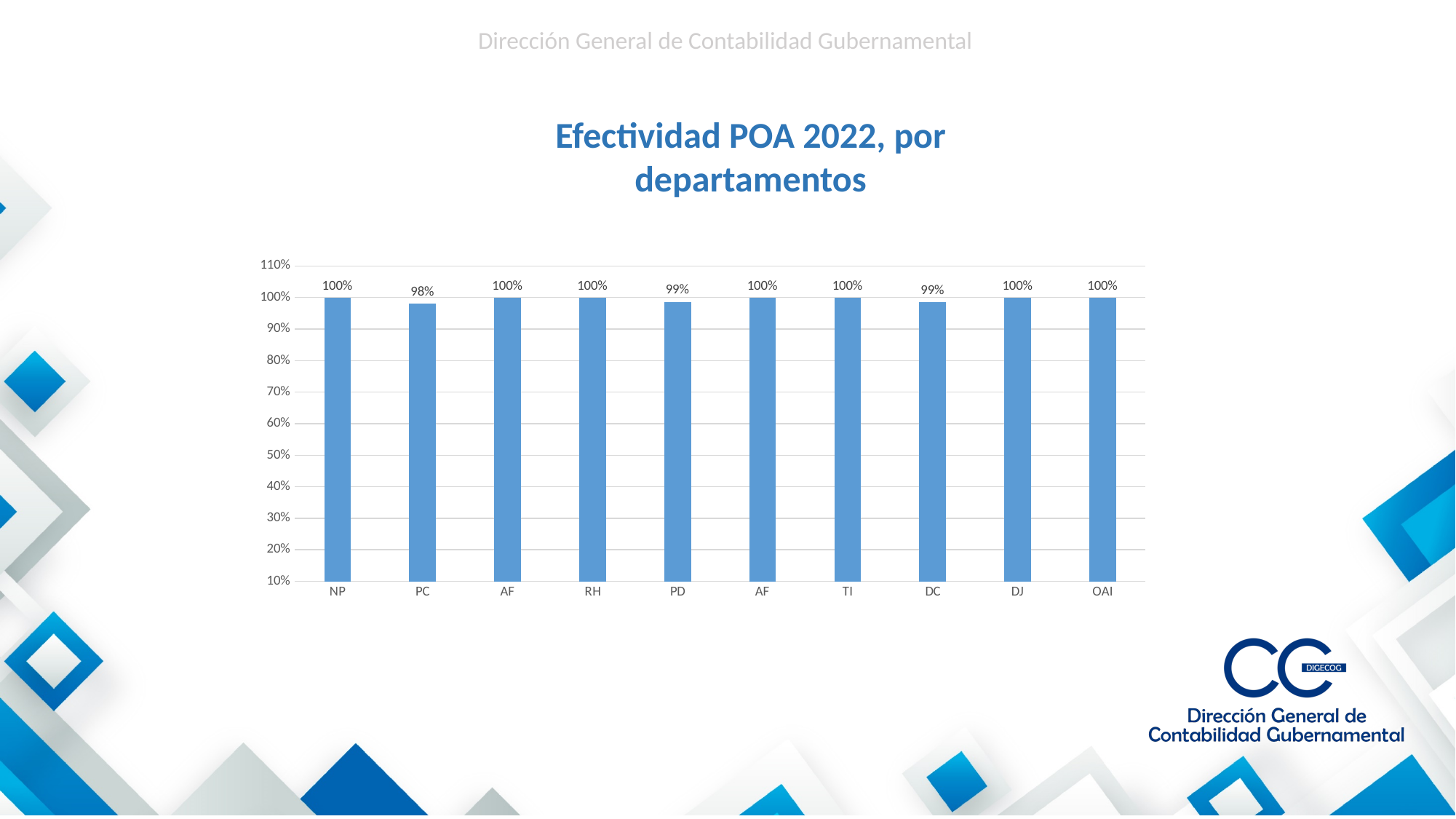
Which is larger, the value for RH or the value for PD? RH Is the value for PC greater or less than 90%? greater Which department has the lowest value? PC What is the value for PD? 99% What is the title of the chart? Efectividad POA 2022, por departamentos How many departments are shown on the x axis? 10 What is the value for NP? 100% What is the value for DC? 99% What is the value for PC? 98% What is the difference between the values for NP and PC? 2% What is the value for OAI? 100% What kind of chart is shown on the slide? bar chart